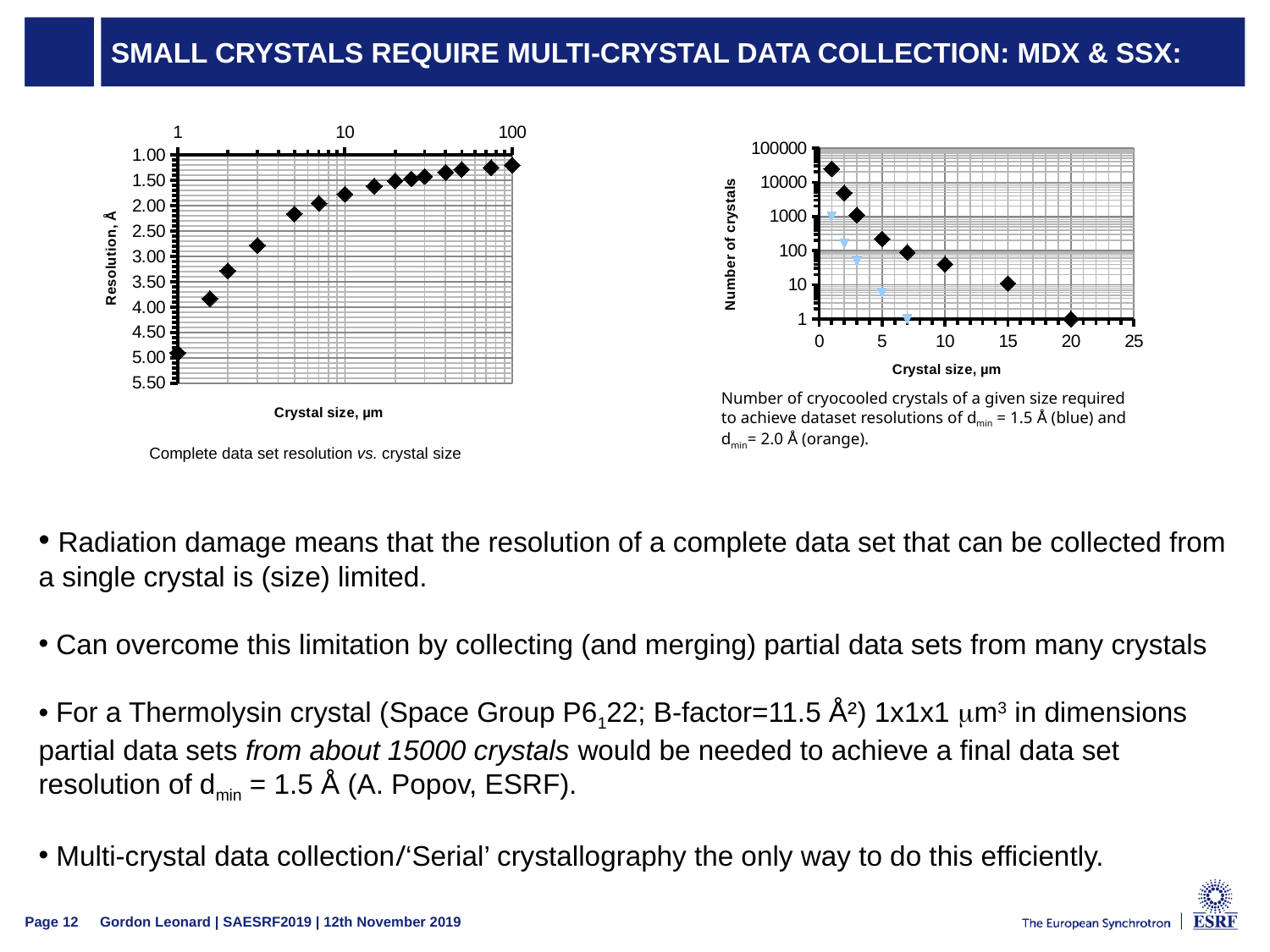
In the right chart, is the number of crystals (black diamonds) at a crystal size of 10 µm greater or less than 100? less In the right chart, what is the label of the x axis? Crystal size, µm In the left chart, is the resolution value at a crystal size of 1 µm greater or less than 4.50? greater In the right chart, is the number of crystals (black diamonds) at a crystal size of 1 µm greater or less than 10000? greater What kind of chart is the right chart showing number of crystals against crystal size? scatter chart In the left chart, do the plotted resolution values rise or fall as crystal size increases along the x axis? fall In the right chart, at a crystal size of 5 µm, which series shows the larger number of crystals: the black diamonds or the blue triangles? black diamonds In the right chart, which crystal size requires the highest number of crystals? 1 µm In the left chart, what is the label of the y axis? Resolution, Å What kind of chart is the left chart, 'Complete data set resolution vs. crystal size'? scatter chart In the right chart, does the number of crystals rise or fall as crystal size increases? fall